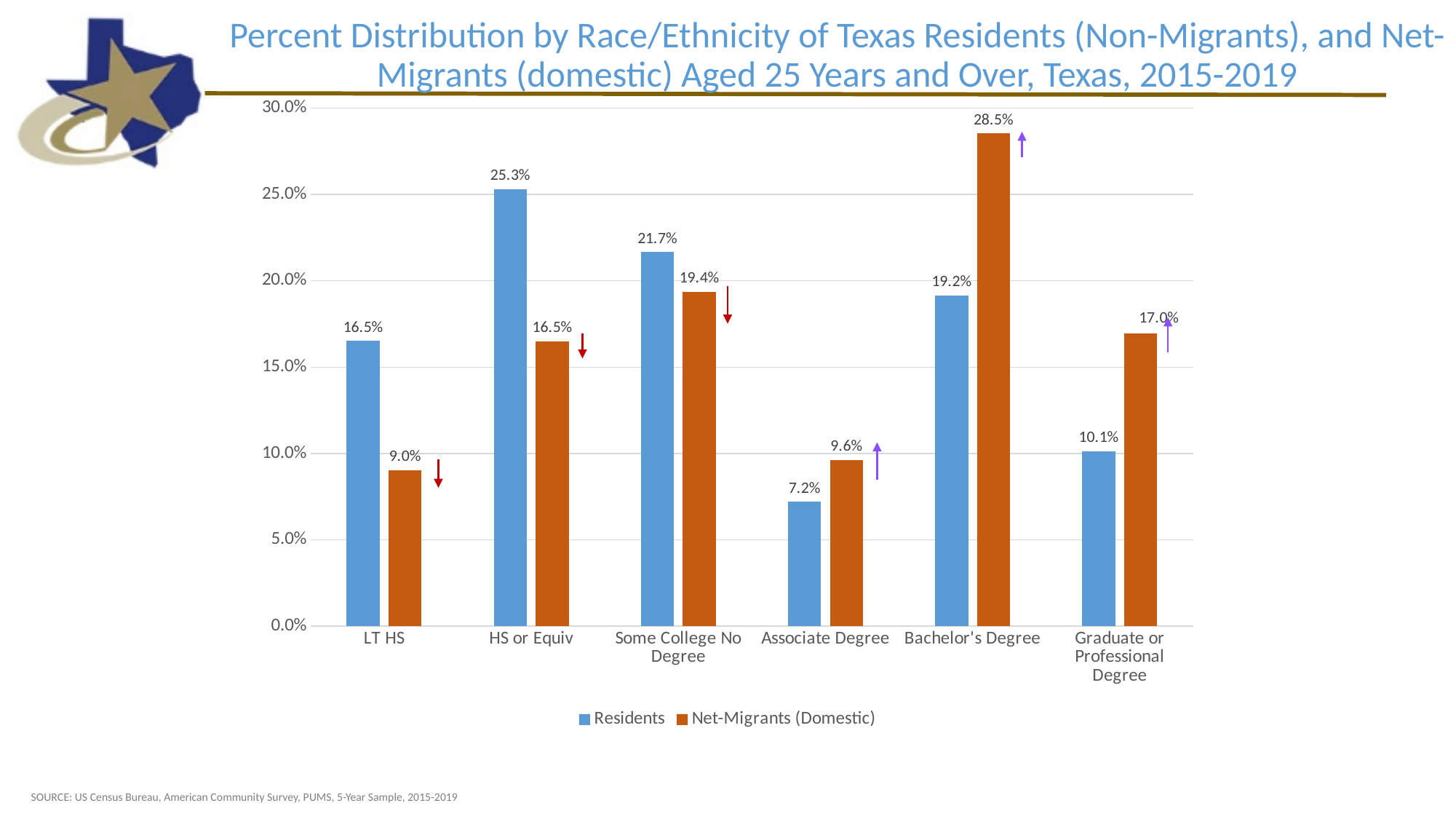
What is the value for Residents in the LT HS category? 16.5% What is the difference between Residents and Net-Migrants (Domestic) in the HS or Equiv category? 8.8% What is the value for Net-Migrants (Domestic) in the Bachelor's Degree category? 28.5% What kind of chart is shown on the slide? Bar chart Which category has the lowest value for Net-Migrants (Domestic)? LT HS Which is larger in the Graduate or Professional Degree category, Residents or Net-Migrants (Domestic)? Net-Migrants (Domestic) How many education categories are shown on the x axis? 6 What is the value for Net-Migrants (Domestic) in the Associate Degree category? 9.6% What colour are the bars for the Net-Migrants (Domestic) series? Orange Is the value for Residents in the Some College No Degree category greater or less than 20.0%? greater Which category has the highest value for Residents? HS or Equiv How many series does the legend list? 2